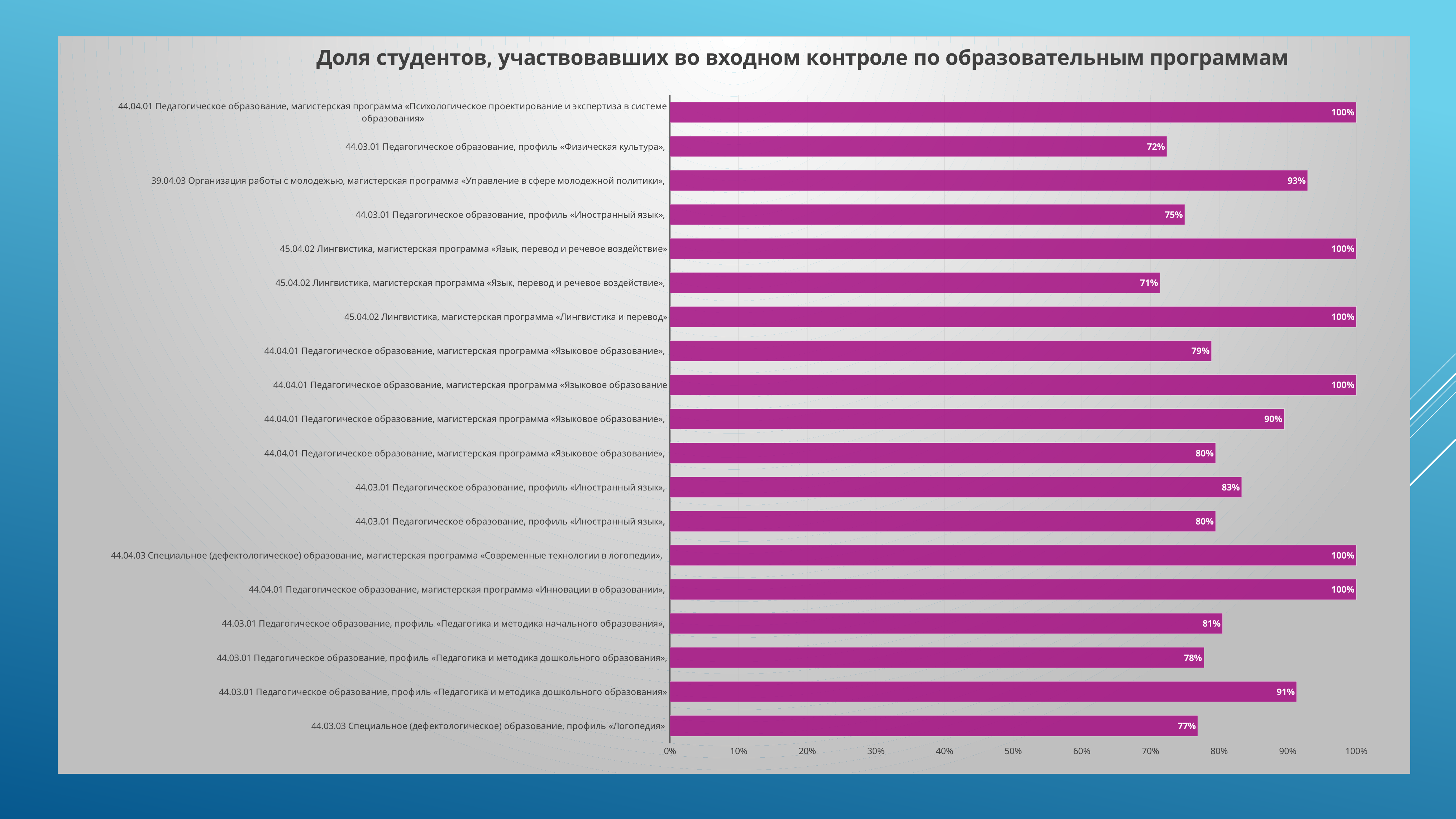
How many bars are shown in the chart? 19 What is the value for «44.03.03 Специальное (дефектологическое) образование, профиль «Логопедия»»? 77% What is the title of the chart? Доля студентов, участвовавших во входном контроле по образовательным программам What is the difference between the value for «Управление в сфере молодежной политики» and the value for «Физическая культура»? 21% Which is larger: the value for «Логопедия» or the value for «Педагогика и методика начального образования»? Педагогика и методика начального образования What is the value for «44.04.03 Специальное (дефектологическое) образование, магистерская программа «Современные технологии в логопедии»»? 100% What is the value for «45.04.02 Лингвистика, магистерская программа «Лингвистика и перевод»»? 100% What kind of chart is shown on the slide? Bar chart What is the lowest value shown in the chart? 71% What is the value for «39.04.03 Организация работы с молодежью, магистерская программа «Управление в сфере молодежной политики»»? 93% What is the value for «44.03.01 Педагогическое образование, профиль «Педагогика и методика начального образования»»? 81% What is the value for «44.03.01 Педагогическое образование, профиль «Физическая культура»»? 72%